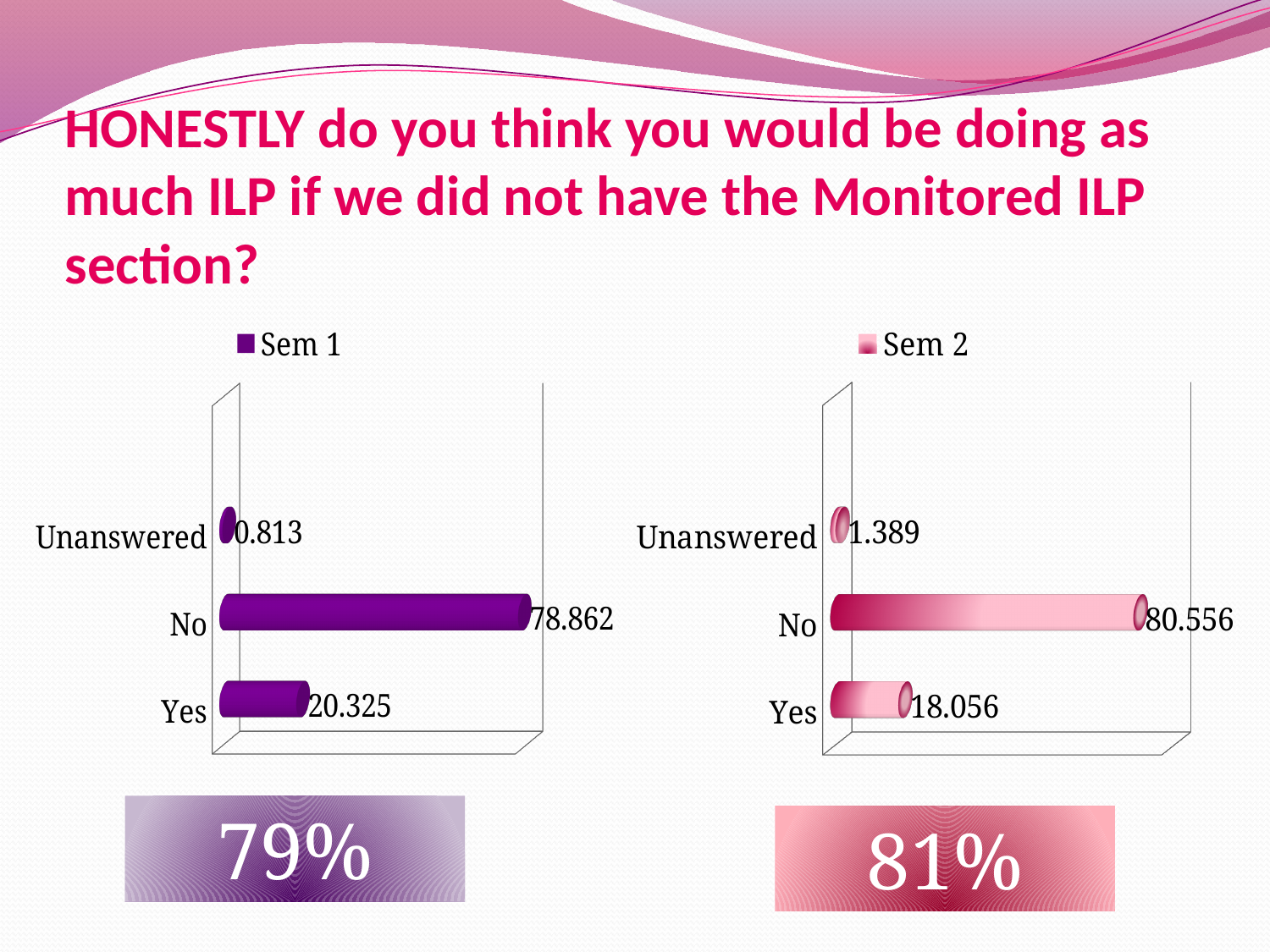
How many series does the legend of the left chart list? 1 In the left chart (Sem 1), what is the value for No? 78.862 In the left chart (Sem 1), what is the value for Unanswered? 0.813 Which is larger: the value for No in the left chart (Sem 1) or the value for No in the right chart (Sem 2)? Sem 2 (80.556) What kind of chart is the left chart (Sem 1)? Bar chart In the left chart (Sem 1), what is the difference between the values for No and Yes? 58.537 In the right chart (Sem 2), what is the value for No? 80.556 What is the legend entry of the right chart? Sem 2 In the left chart (Sem 1), which category has the highest value? No In the right chart (Sem 2), which category has the lowest value? Unanswered In the right chart (Sem 2), what is the value for Yes? 18.056 How many categories are shown in the right chart (Sem 2)? 3